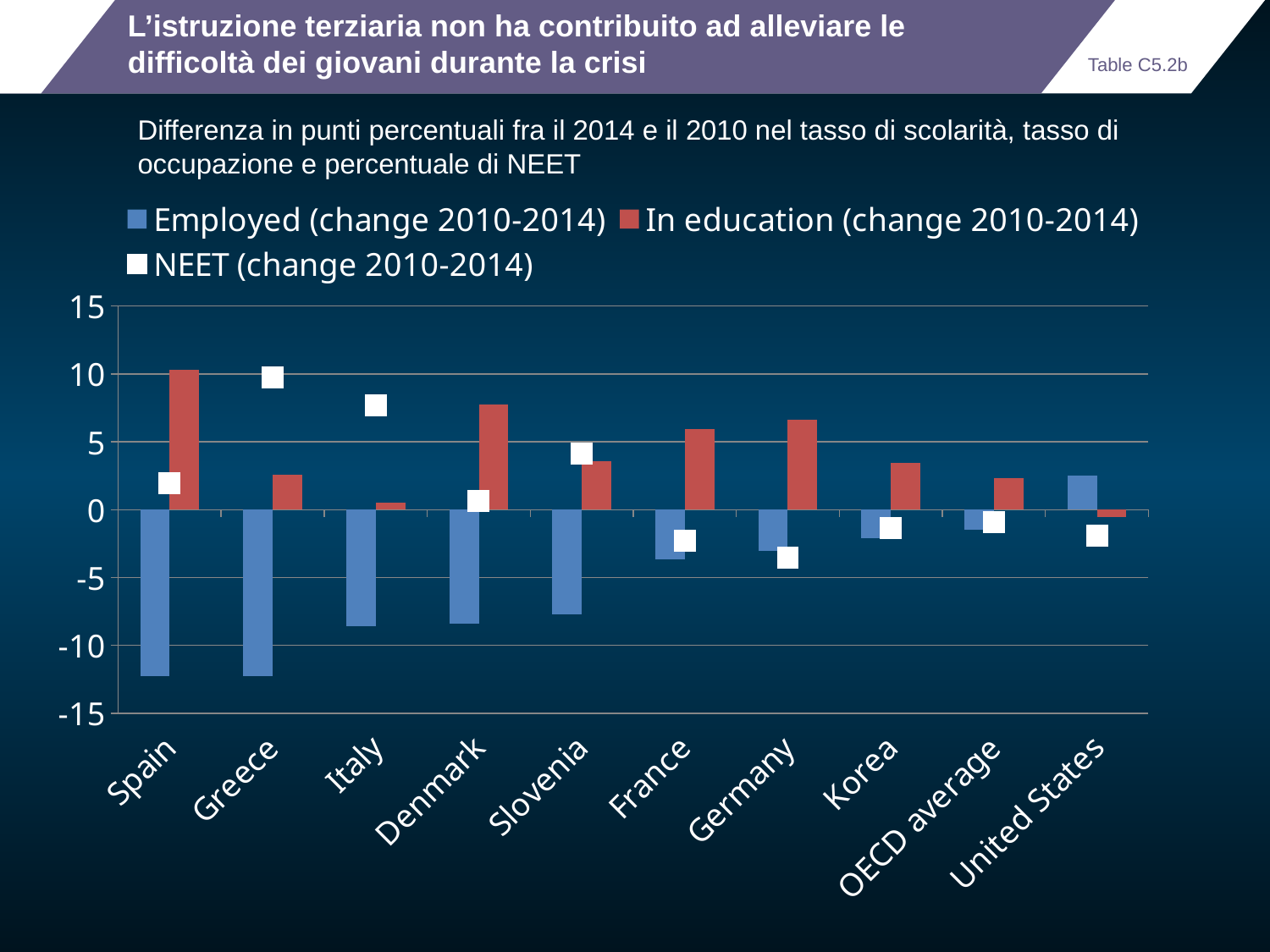
Is the Employed (change 2010-2014) value for Spain greater or less than -10? less Which is larger, the In education (change 2010-2014) value for Spain or for Denmark? Spain Is the NEET (change 2010-2014) value for Greece greater or less than 5? greater Which category has the highest value for In education (change 2010-2014)? Spain Which colour represents the NEET (change 2010-2014) series in the legend? white Which category has the lowest value for NEET (change 2010-2014)? Germany How many series does the legend list? 3 Which category has the lowest value for In education (change 2010-2014)? United States Which category has the highest value for NEET (change 2010-2014)? Greece Which category has the highest value for Employed (change 2010-2014)? United States How many countries/categories are shown on the x axis? 10 What kind of chart is shown on the slide? combination bar and line chart